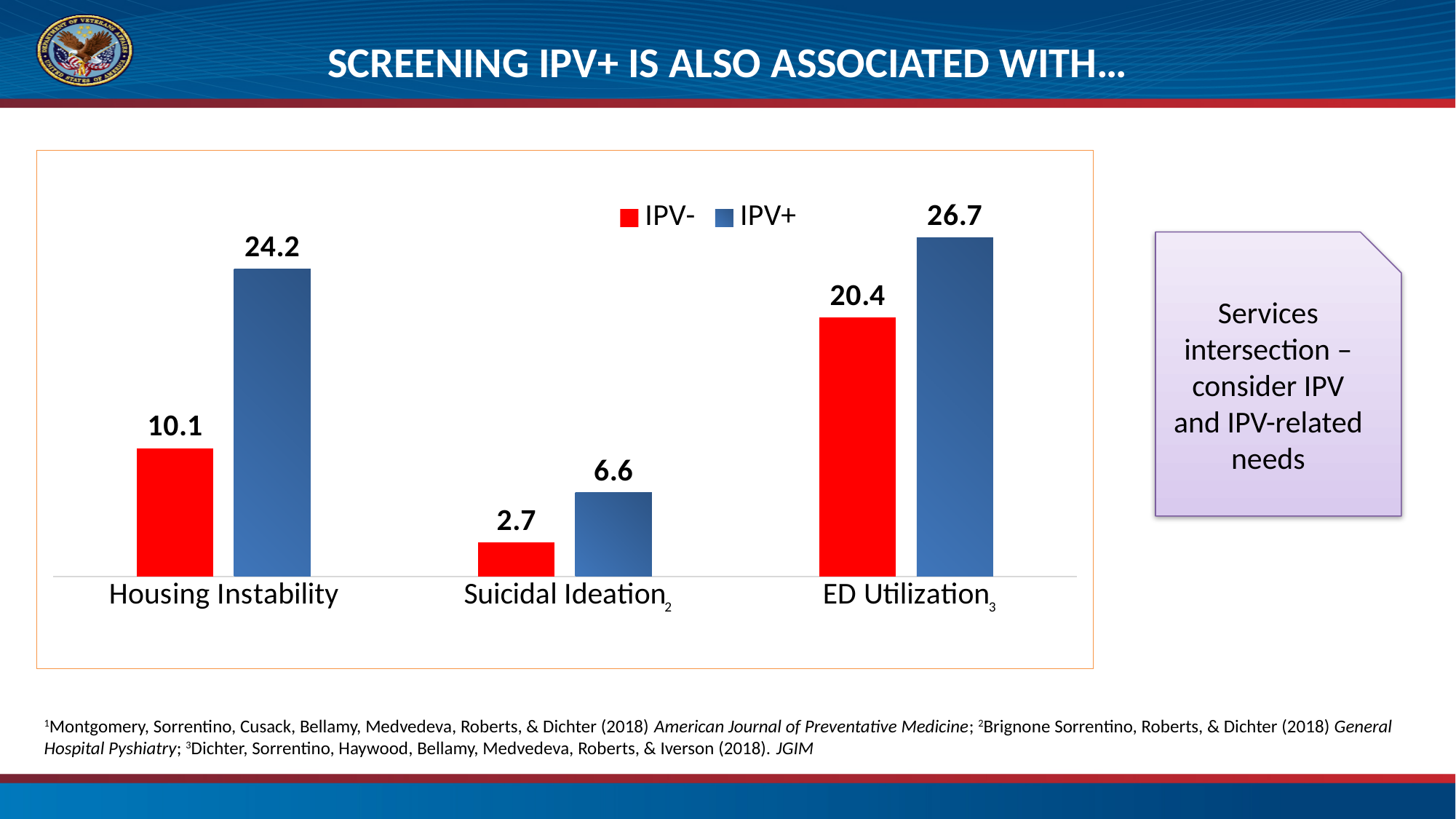
What is the IPV- value for Suicidal Ideation? 2.7 What is the difference between the IPV+ and IPV- values for Housing Instability? 14.1 Which category has the highest IPV+ value? ED Utilization How many series does the legend list? 2 What kind of chart is shown on the slide? Bar chart What is the IPV+ value for Housing Instability? 24.2 Which is larger: the IPV- value for ED Utilization or the IPV+ value for Housing Instability? IPV+ value for Housing Instability Which category has the lowest IPV- value? Suicidal Ideation How many categories are shown on the x axis? 3 What is the IPV- value for ED Utilization? 20.4 What is the difference between the IPV+ and IPV- values for ED Utilization? 6.3 What is the IPV+ value for Suicidal Ideation? 6.6